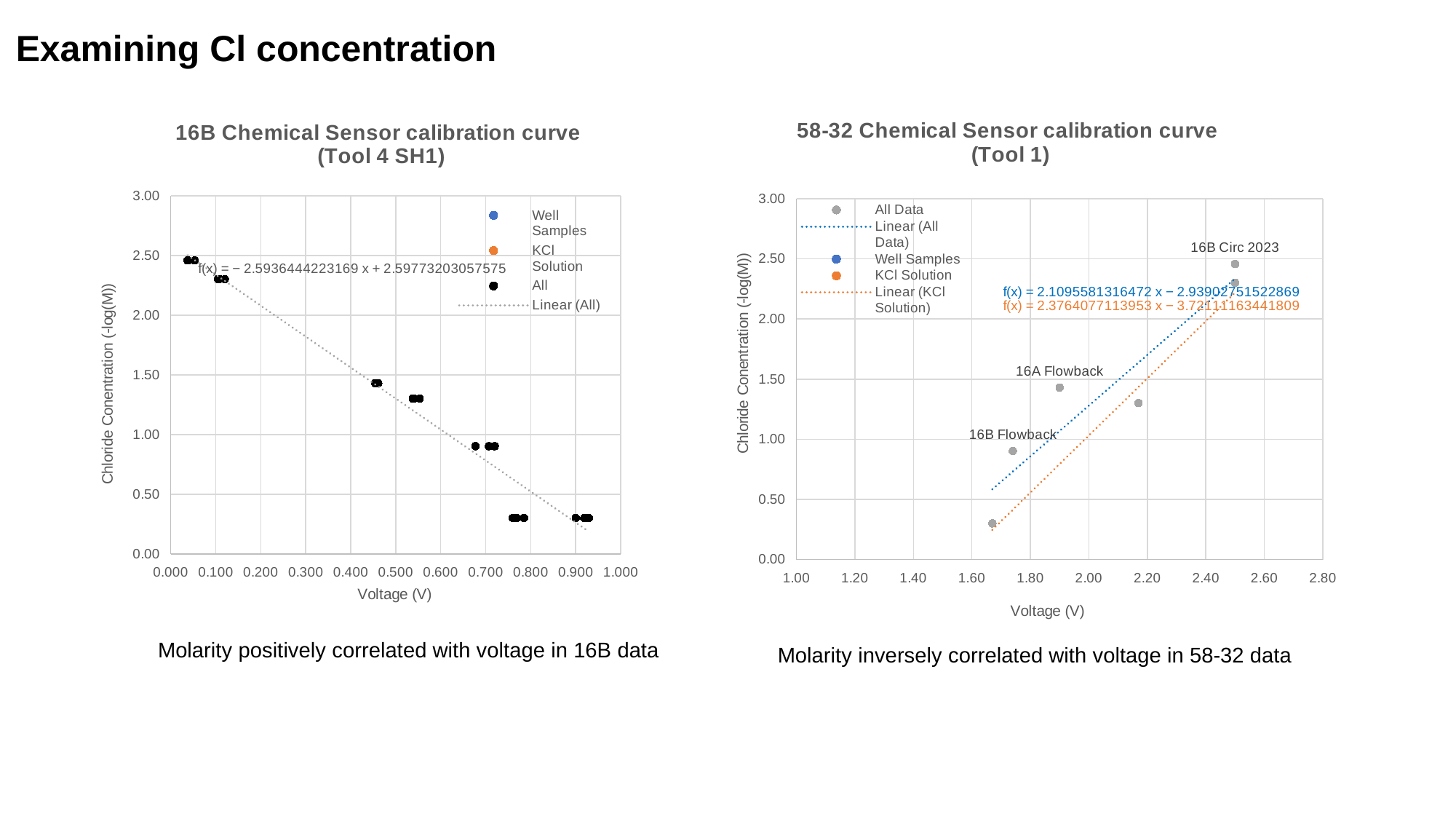
In the 58-32 Chemical Sensor calibration curve (Tool 1) chart, is the voltage for 16B Circ 2023 greater or less than 2.40? greater In the 58-32 Chemical Sensor calibration curve (Tool 1) chart, do the chloride concentration values rise or fall as voltage increases? Rise In the 58-32 Chemical Sensor calibration curve (Tool 1) chart, is the chloride concentration value for 16B Flowback greater or less than 1.00? less In the 58-32 Chemical Sensor calibration curve (Tool 1) chart, which labelled point has the higher chloride concentration, 16B Circ 2023 or 16B Flowback? 16B Circ 2023 What is the x-axis label of the 16B Chemical Sensor calibration curve (Tool 4 SH1) chart? Voltage (V) How many entries does the legend of the 58-32 Chemical Sensor calibration curve (Tool 1) chart list? 5 What kind of chart is the 16B Chemical Sensor calibration curve (Tool 4 SH1)? Scatter chart How many entries does the legend of the 16B Chemical Sensor calibration curve (Tool 4 SH1) chart list? 4 In the 58-32 Chemical Sensor calibration curve (Tool 1) chart, which labelled point has the lowest chloride concentration? 16B Flowback In the 16B Chemical Sensor calibration curve (Tool 4 SH1) chart, do the chloride concentration values rise or fall as voltage increases? Fall In the 58-32 Chemical Sensor calibration curve (Tool 1) chart, is the chloride concentration value for 16B Circ 2023 greater or less than 2.00? greater What is the y-axis label of the 58-32 Chemical Sensor calibration curve (Tool 1) chart? Chloride Conentration (-log(M))